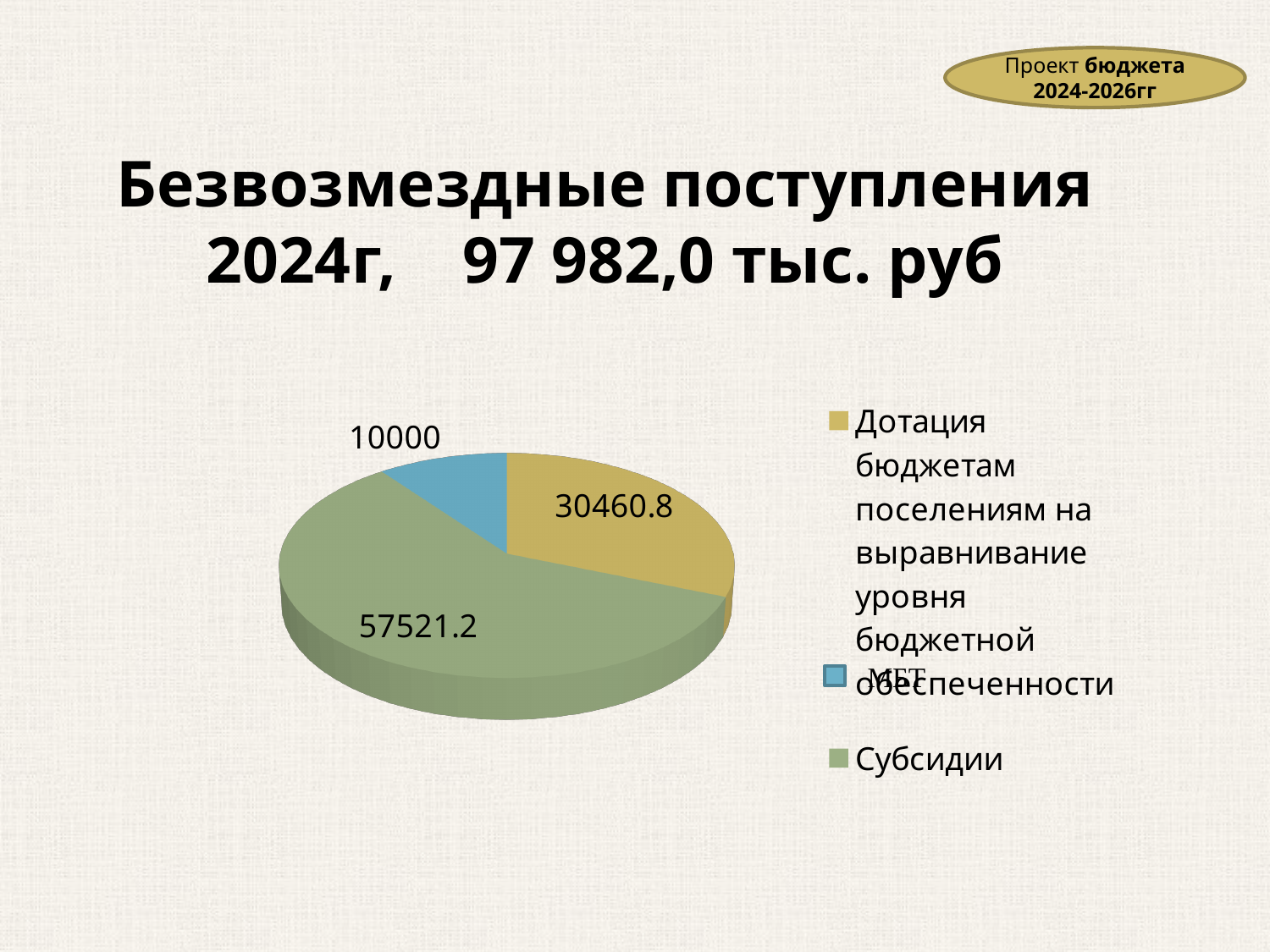
How many entries does the legend list? 3 What is the sum of all three slice values? 97982.0 Which is larger, the Дотация slice or the МБТ slice? Дотация What kind of chart is shown on the slide? pie chart What colour is the Субсидии slice? green Which category has the smallest slice of the pie? МБТ Which category has the largest slice of the pie? Субсидии What is the value of the Субсидии slice? 57521.2 How many slices does the pie chart have? 3 What is the value of the slice for Дотация бюджетам поселениям на выравнивание уровня бюджетной обеспеченности? 30460.8 What is the value of the МБТ slice? 10000 What is the difference between the Субсидии value and the Дотация value? 27060.4